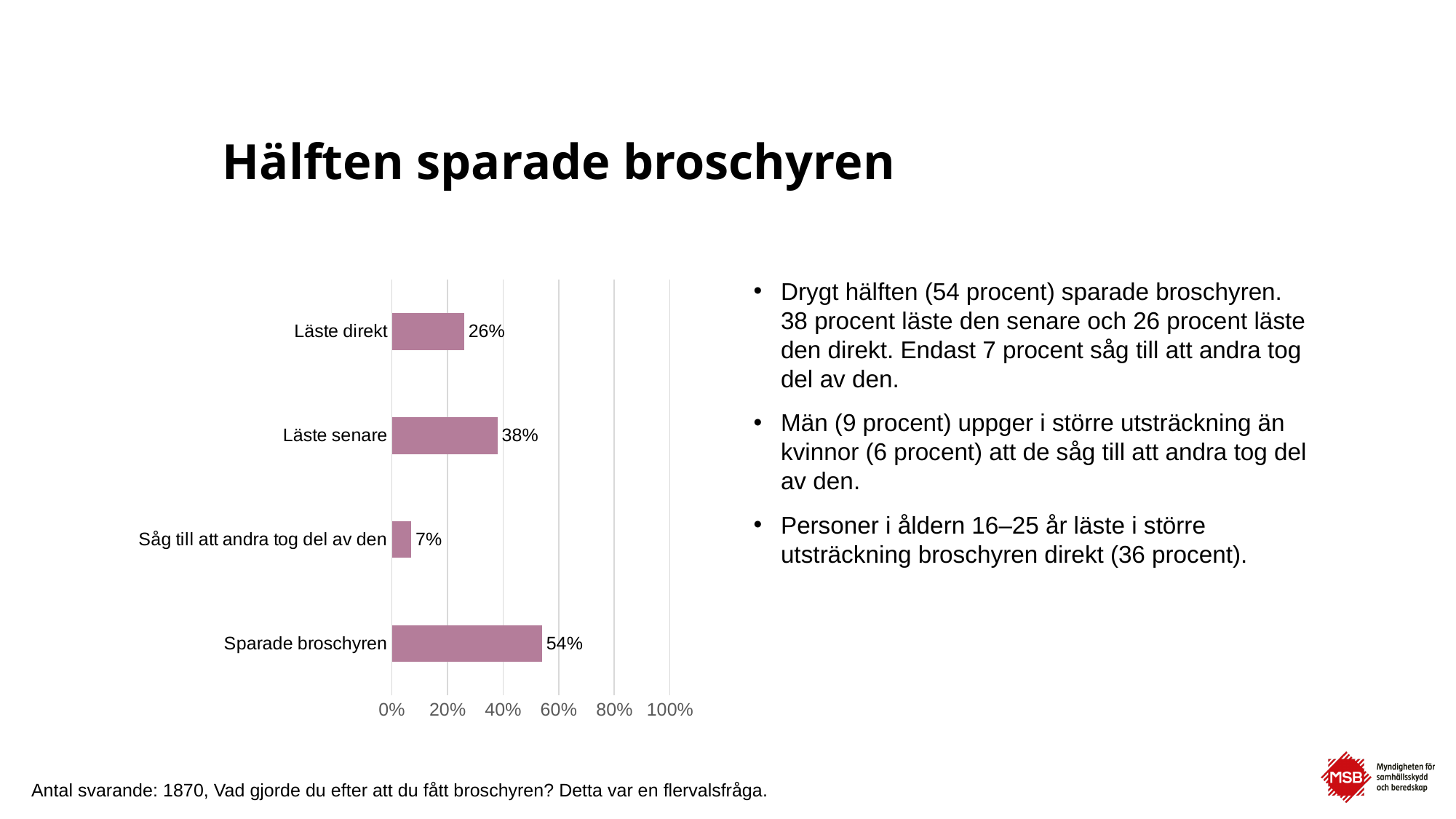
What is the value for "Läste direkt"? 26% How many categories are shown in the chart? 4 Which category has the highest value? Sparade broschyren What is the value for "Läste senare"? 38% What is the value for "Såg till att andra tog del av den"? 7% Is the value for "Läste senare" greater or less than 40%? less Which category has the lowest value? Såg till att andra tog del av den What is the value for "Sparade broschyren"? 54% What kind of chart is shown on the slide? bar chart Which is larger, the value for "Läste senare" or the value for "Läste direkt"? Läste senare What is the difference between the values for "Sparade broschyren" and "Läste senare"? 16% What is the difference between the values for "Läste direkt" and "Såg till att andra tog del av den"? 19%